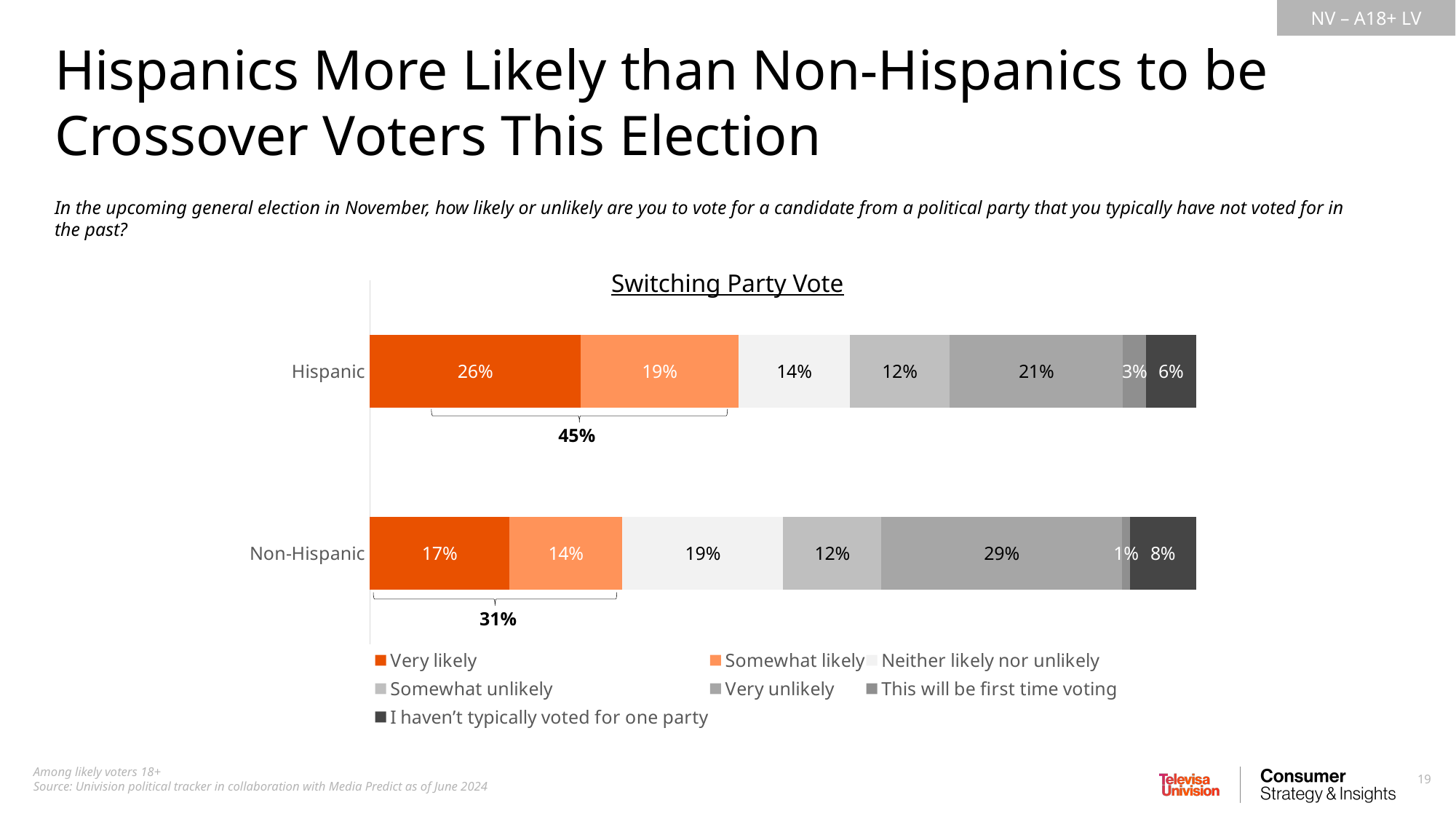
What is the combined "Very likely" plus "Somewhat likely" share shown for Non-Hispanic respondents? 31% How many series does the legend list? 7 How many groups (categories) are plotted in the chart? 2 Which response category has the largest share among Non-Hispanic respondents? Very unlikely Which group has the higher "Neither likely nor unlikely" value, Hispanic or Non-Hispanic? Non-Hispanic What percentage of Non-Hispanic respondents are "Very unlikely" to switch their party vote? 29% What is the difference between the "Very likely" values for Hispanic and Non-Hispanic respondents? 9 percentage points What percentage of Hispanic respondents are "Very likely" to vote for a candidate from a party they typically have not voted for? 26% What is the "Somewhat likely" value for Non-Hispanic respondents? 14% What is the combined "Very likely" plus "Somewhat likely" share shown for Hispanic respondents? 45% Which response category has the smallest share among Non-Hispanic respondents? This will be first time voting What type of chart is shown on the slide? Stacked bar chart